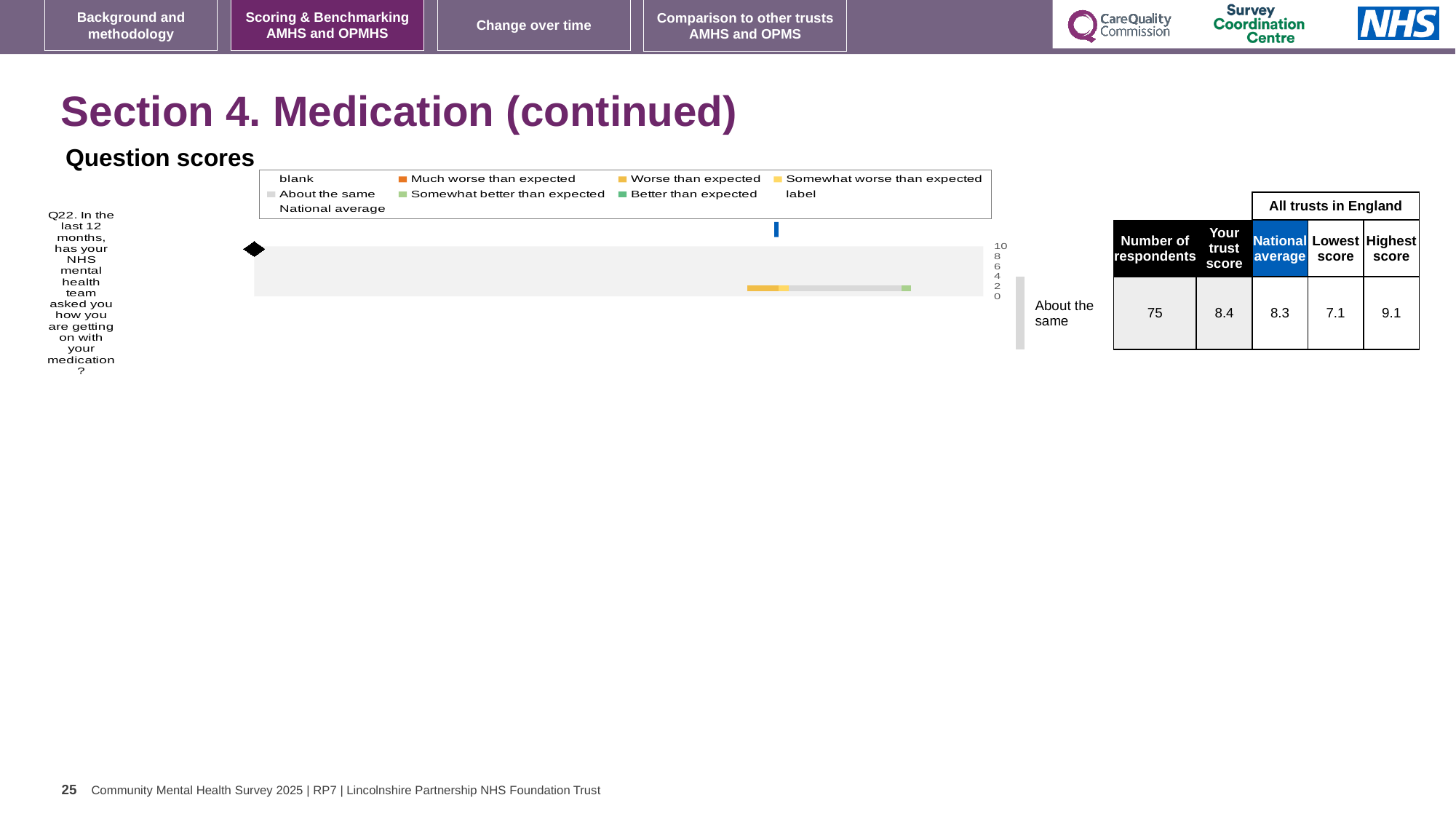
What is the lowest score among all trusts in England for Q22? 7.1 How many questions are plotted in the Question scores chart? 1 How many respondents answered Q22? 75 What kind of chart is used to show the Q22 question score? bar chart What is the trust score for Q22 shown alongside the chart? 8.4 What is the highest value shown on the axis of the Question scores chart? 10 What is the highest score among all trusts in England for Q22? 9.1 Which legend entry in the Question scores chart is shown in orange? Much worse than expected What is the national average for Q22 shown alongside the chart? 8.3 How many entries does the legend of the Question scores chart list? 9 Which is larger for Q22, the trust score or the national average? the trust score What benchmark category is Q22 assigned in the Question scores chart? About the same